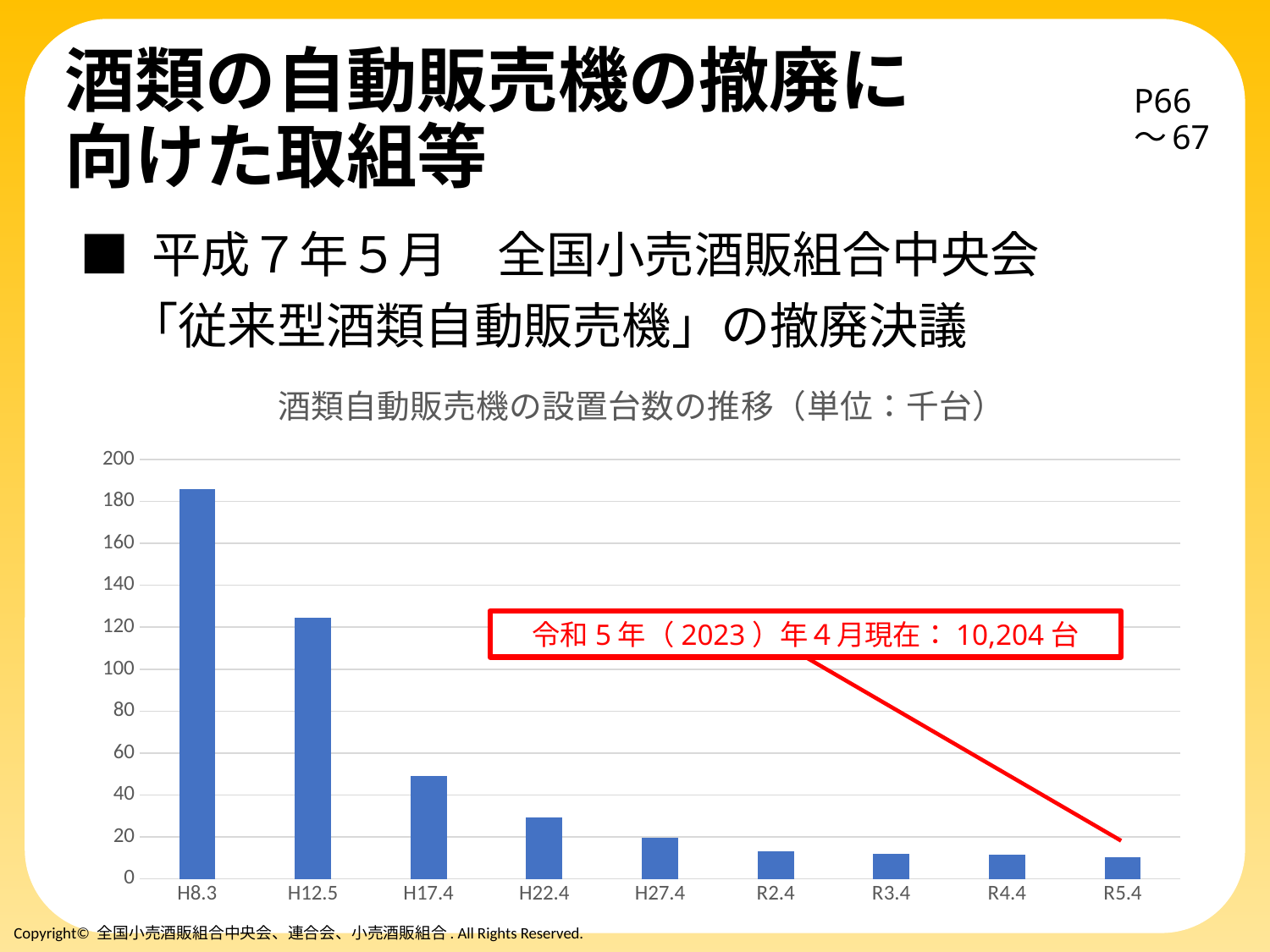
Is the value for R2.4 greater or less than 20? less What kind of chart is shown on the slide? bar chart Which category has the highest value in the chart? H8.3 Which is larger, the value for H12.5 or the value for H17.4? H12.5 Is the value for H22.4 greater or less than 40? less What is the title of the chart? 酒類自動販売機の設置台数の推移（単位：千台） According to the annotation on the chart, how many units were installed as of April 2023 (令和5年4月)? 10,204台 Is the value for H17.4 greater or less than 60? less How many categories are shown on the x axis of the chart? 9 Do the values rise or fall from H8.3 to R5.4 along the x axis? fall